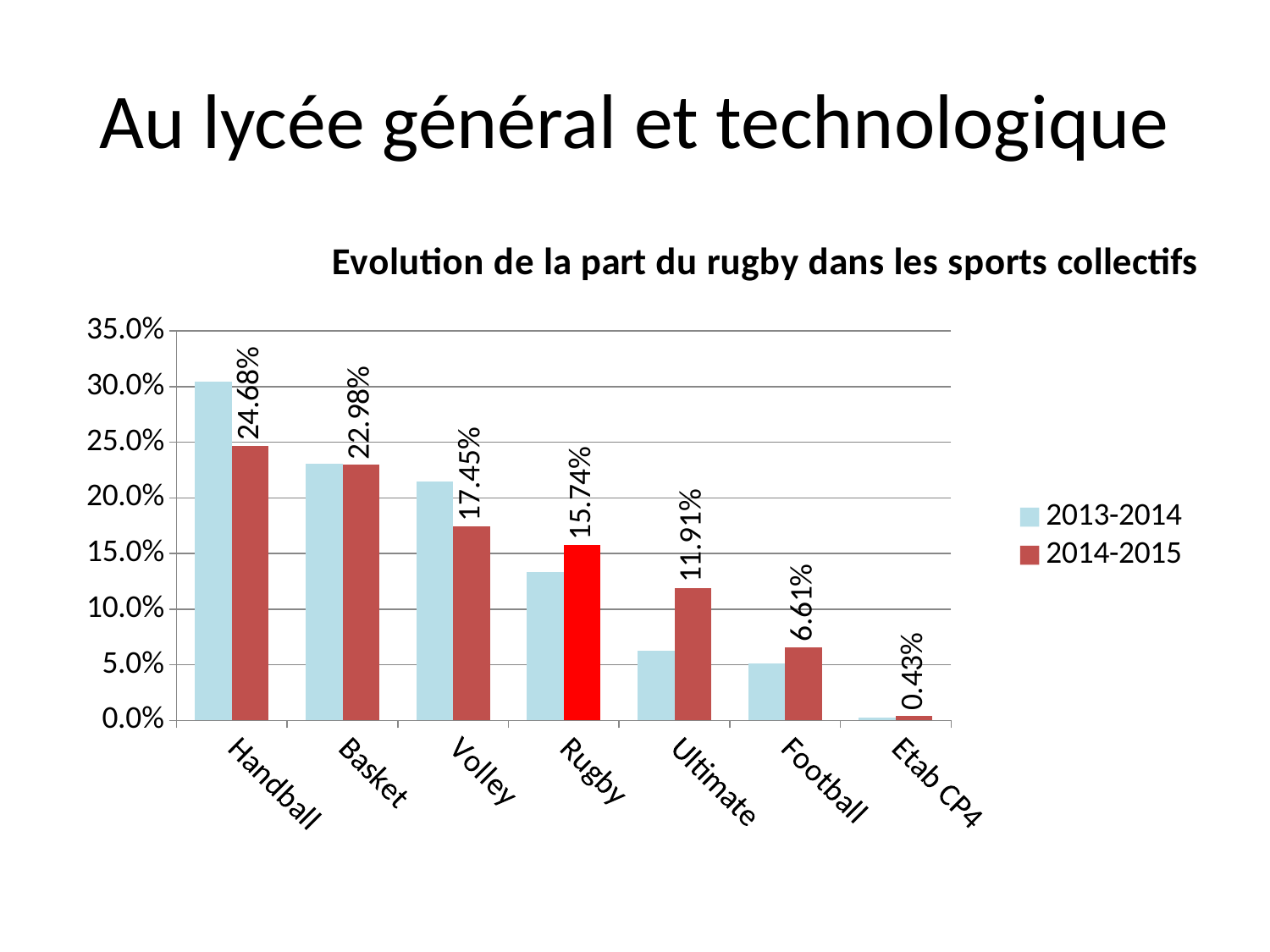
Which category has the lowest value in the 2014-2015 series? Etab CP4 In the 2014-2015 series, which is larger: Volley or Rugby? Volley What is the value for Handball in the 2014-2015 series? 24.68% What is the value for Rugby in the 2014-2015 series? 15.74% Is the 2013-2014 value for Rugby greater or less than 15%? less How many categories are shown on the x axis? 7 Do the 2014-2015 values rise or fall from left to right along the x axis? fall How many series does the legend list? 2 Which category has the highest value in the 2014-2015 series? Handball What is the difference between the 2014-2015 values for Handball and Basket? 1.70% What is the value for Football in the 2014-2015 series? 6.61% For Handball, which series has the larger value: 2013-2014 or 2014-2015? 2013-2014